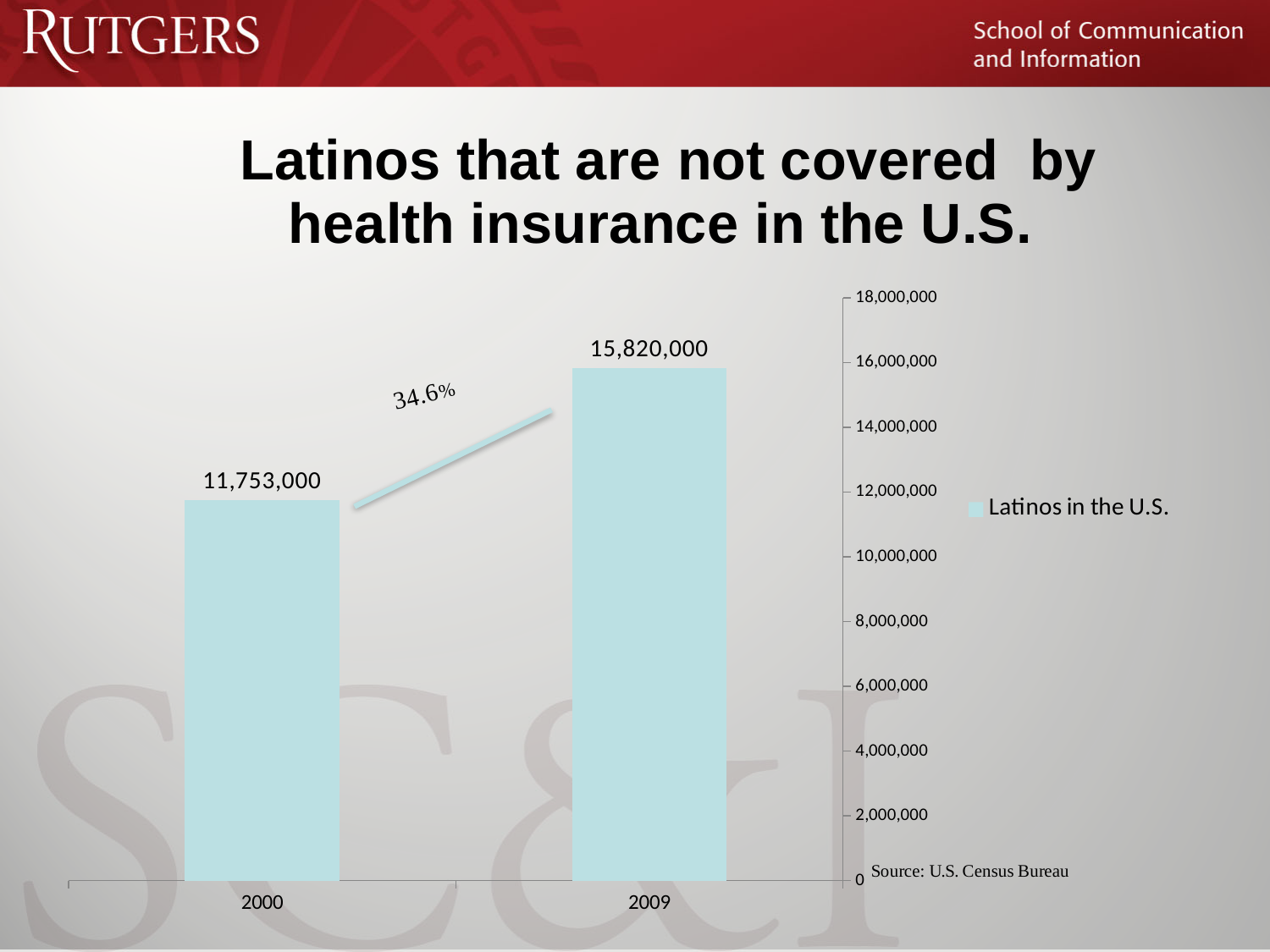
What is the value for 2000? 11,753,000 Do the values rise or fall from 2000 to 2009? rise How many series does the legend list? 1 Is the value for 2009 greater or less than 14,000,000? greater What is the difference between the 2009 and 2000 values? 4,067,000 Which year has the higher value? 2009 What kind of chart is shown? bar chart What percentage change is annotated between the two bars? 34.6% What is the value for 2009? 15,820,000 How many years are shown on the x axis? 2 Which year has the lower value? 2000 Is the value for 2000 greater or less than 12,000,000? less